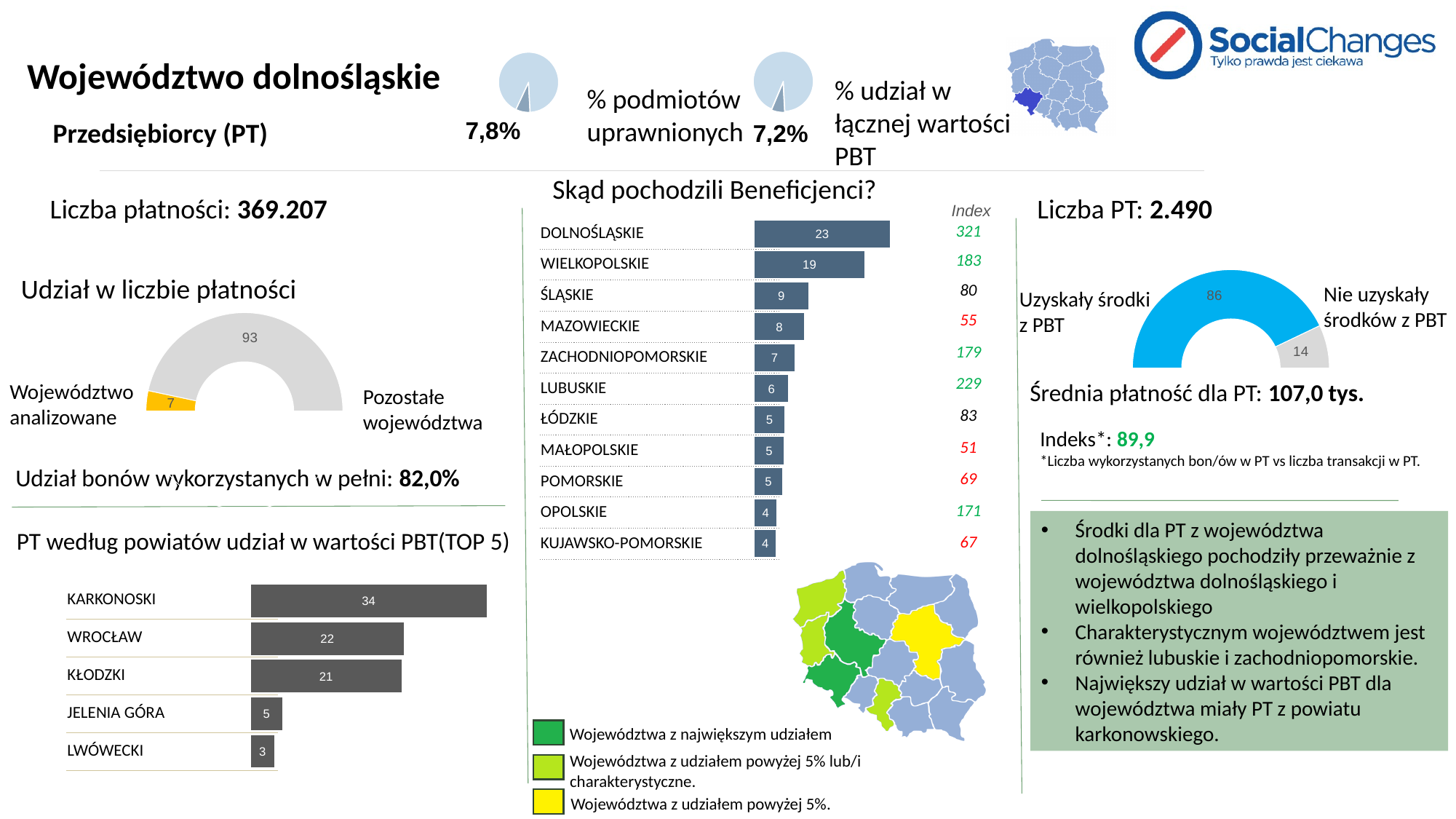
In the 'Skąd pochodzili Beneficjenci?' chart, which voivodeship has the highest value? DOLNOŚLĄSKIE In the 'Skąd pochodzili Beneficjenci?' chart, what is the value for WIELKOPOLSKIE? 19 In the 'Liczba PT' donut chart, what is the value for 'Nie uzyskały środków z PBT'? 14 In the 'PT według powiatów udział w wartości PBT(TOP 5)' chart, which powiat has the lowest value? LWÓWECKI In the 'PT według powiatów udział w wartości PBT(TOP 5)' chart, what is the value for KARKONOSKI? 34 What kind of chart is 'PT według powiatów udział w wartości PBT(TOP 5)'? Bar chart In the 'Udział w liczbie płatności' chart, what is the value for 'Województwo analizowane'? 7 In the 'Skąd pochodzili Beneficjenci?' chart, what is the difference between the values for DOLNOŚLĄSKIE and ŚLĄSKIE? 14 In the 'PT według powiatów udział w wartości PBT(TOP 5)' chart, what is the difference between the values for WROCŁAW and JELENIA GÓRA? 17 In the 'Skąd pochodzili Beneficjenci?' chart, what Index value is shown for LUBUSKIE? 229 In the 'Skąd pochodzili Beneficjenci?' chart, which is larger: the value for MAZOWIECKIE or ZACHODNIOPOMORSKIE? MAZOWIECKIE In the 'Skąd pochodzili Beneficjenci?' chart, how many voivodeships are listed? 11